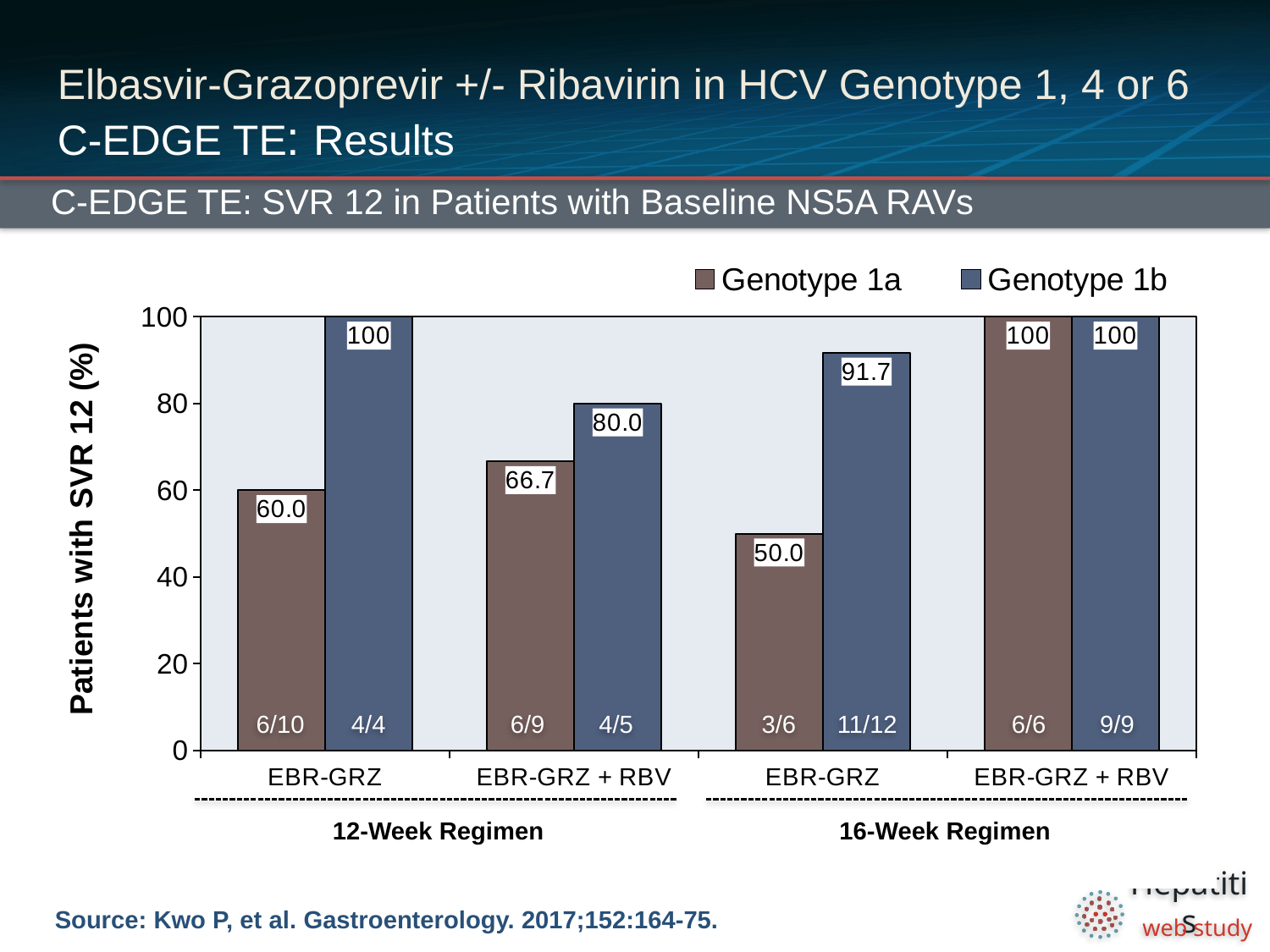
What is the label of the y axis? Patients with SVR 12 (%) In the 12-Week Regimen EBR-GRZ + RBV group, which genotype has the higher SVR 12 value? Genotype 1b What is the difference between the Genotype 1b and Genotype 1a SVR 12 values in the 12-Week Regimen EBR-GRZ group? 40.0 How many series does the legend list? 2 What is the SVR 12 value for Genotype 1a in the 12-Week Regimen EBR-GRZ group? 60.0 What fraction of patients is shown for Genotype 1b in the 16-Week Regimen EBR-GRZ group? 11/12 Which group has the lowest SVR 12 value for Genotype 1a? EBR-GRZ (16-Week Regimen) Is the Genotype 1a value for the 16-Week Regimen EBR-GRZ group greater or less than 60? less How many treatment groups are shown on the x axis? 4 What is the SVR 12 value for Genotype 1a in the 12-Week Regimen EBR-GRZ + RBV group? 66.7 What kind of chart is shown on the slide? Bar chart What is the SVR 12 value for Genotype 1b in the 16-Week Regimen EBR-GRZ group? 91.7